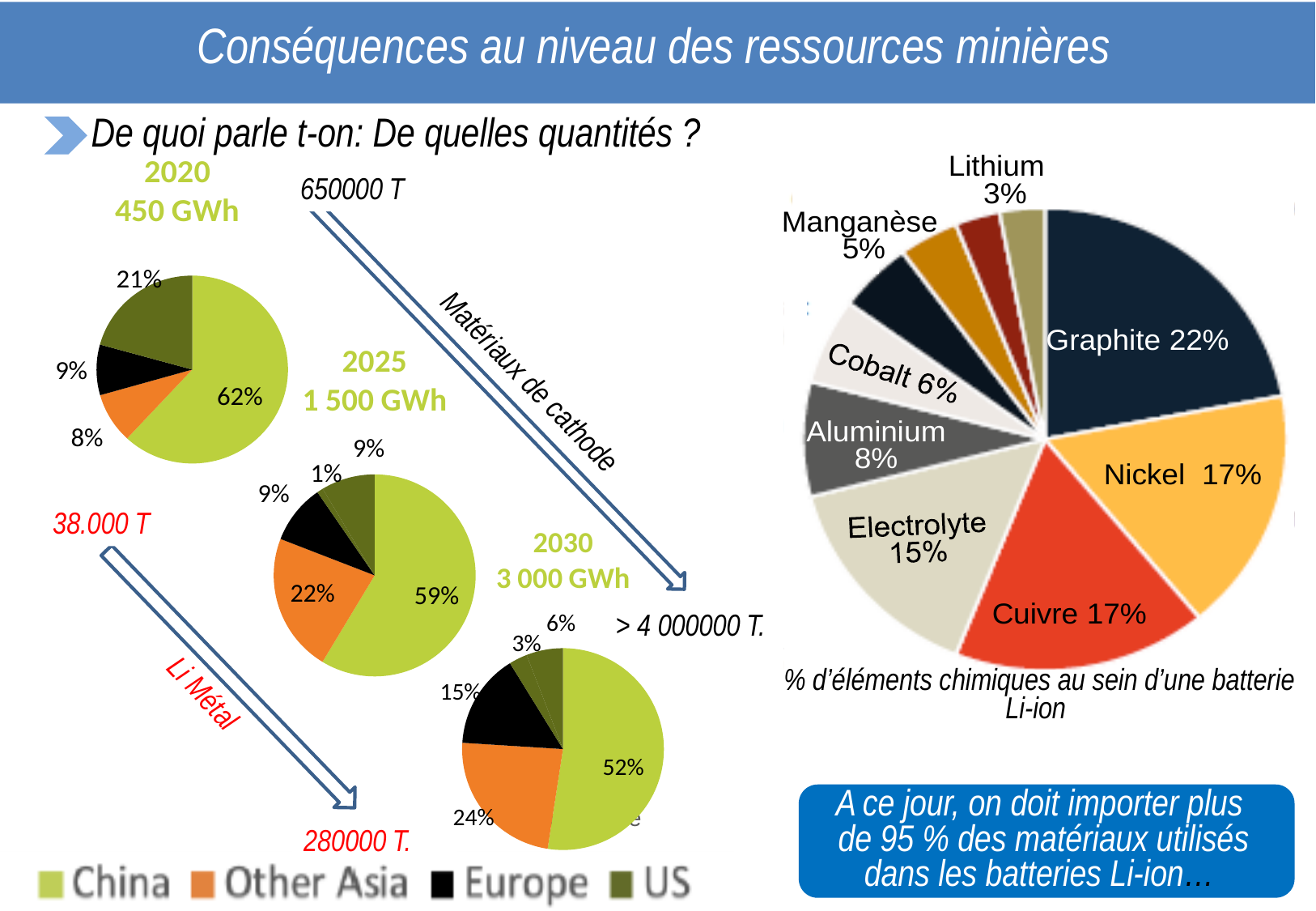
How many entries does the legend at the bottom left list for the regional pie charts? 4 In the Li-ion battery composition pie chart on the right, what is the difference between the Graphite share and the Nickel share? 5 percentage points In the 2030 (3 000 GWh) pie chart, what share does China hold? 52% Across the 2020, 2025 and 2030 pie charts, does China's share rise or fall over time? Fall In the Li-ion battery composition pie chart on the right, what percentage is Graphite? 22% In the 2025 (1 500 GWh) pie chart, what share does Other Asia hold? 22% In the Li-ion battery composition pie chart on the right, what percentage is Lithium? 3% In the 2020 (450 GWh) pie chart, what share does China hold? 62% In the Li-ion battery composition pie chart on the right, which is larger, Cobalt or Aluminium? Aluminium In the Li-ion battery composition pie chart on the right, which labelled element has the largest share? Graphite What kind of charts are shown on the slide? Pie charts In the 2030 (3 000 GWh) pie chart, what is the difference between the Other Asia share and the Europe share? 9 percentage points